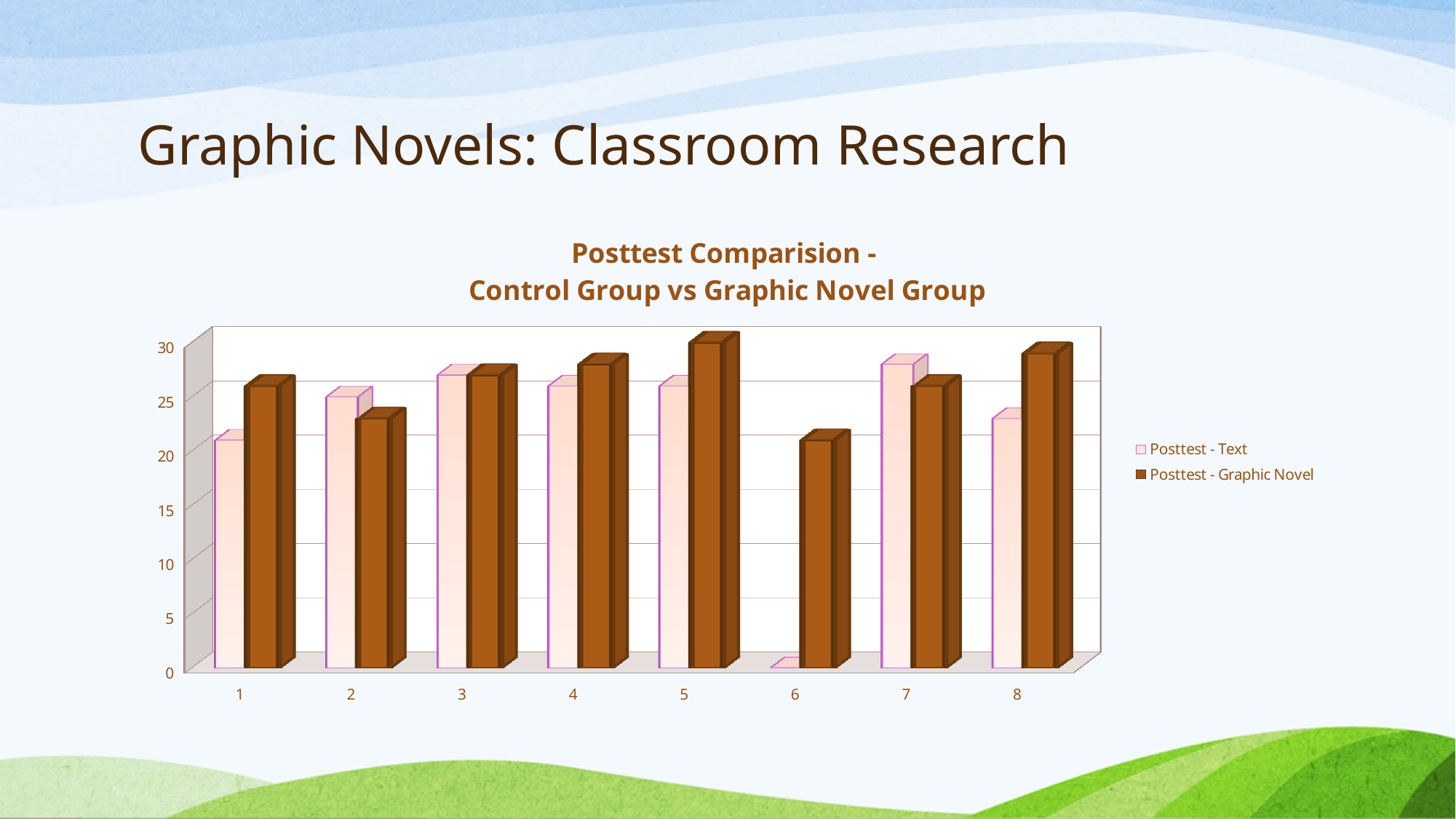
How many categories are shown along the x axis of the chart? 8 Is the Posttest - Text value for category 1 greater or less than 25? less Is the Posttest - Text value for category 7 greater or less than 25? greater For category 6, which is larger: Posttest - Text or Posttest - Graphic Novel? Posttest - Graphic Novel What is the title of the chart? Posttest Comparision - Control Group vs Graphic Novel Group Which series is shown with the dark brown bars? Posttest - Graphic Novel Is the Posttest - Graphic Novel value for category 5 greater or less than 25? greater What kind of chart is shown on the slide? bar chart For which category is the Posttest - Text value lowest? 6 For category 1, which is larger: Posttest - Text or Posttest - Graphic Novel? Posttest - Graphic Novel How many series does the chart's legend list? 2